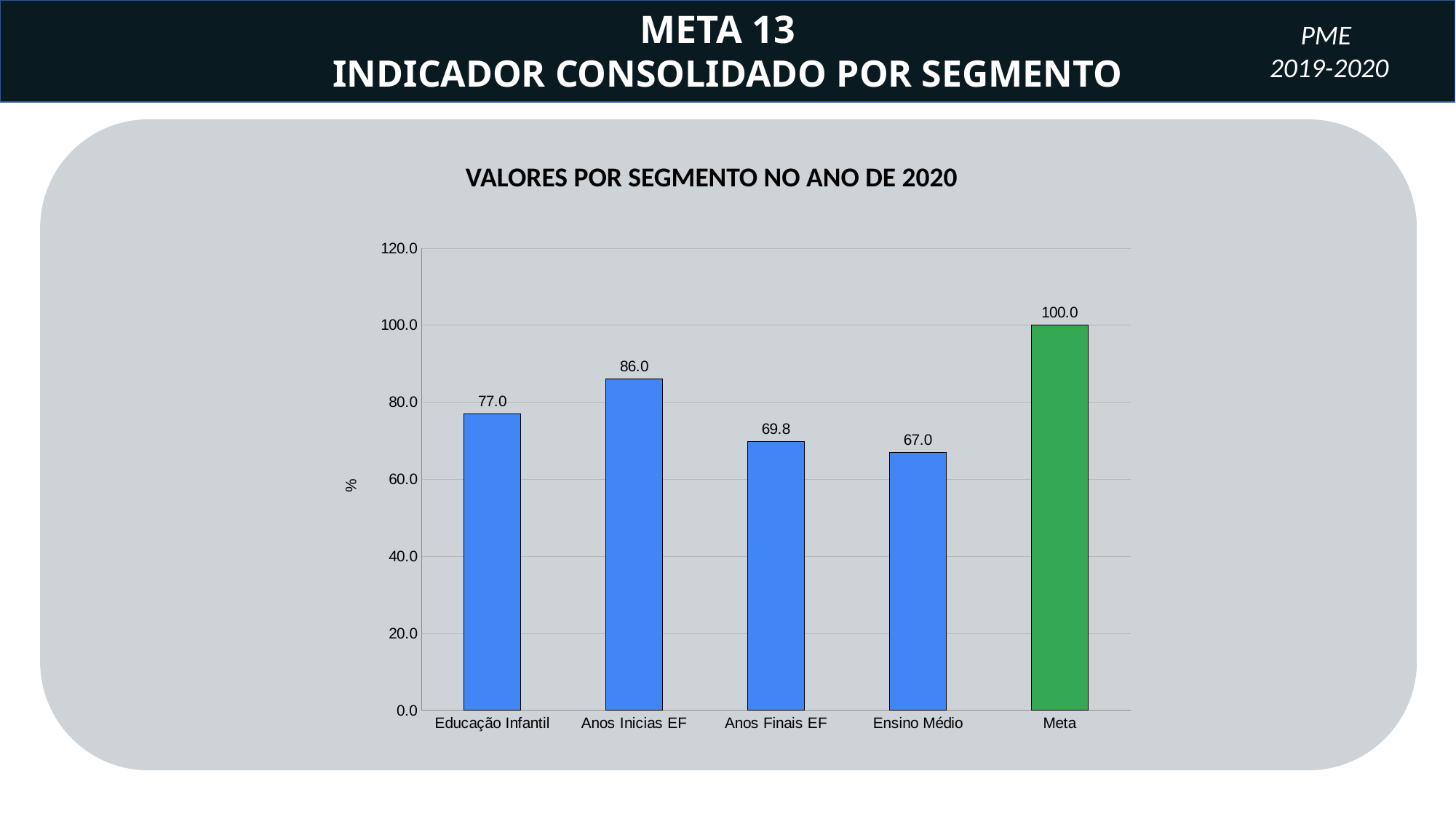
What is the value for Anos Inicias EF? 86.0 What is the difference between the Meta value and the Anos Inicias EF value? 14.0 Which is larger, the value for Educação Infantil or the value for Anos Finais EF? Educação Infantil How many bars are shown in the chart? 5 What colour is the Meta bar? Green What kind of chart is shown on the slide? Bar chart What is the value for Educação Infantil? 77.0 Which category has the highest value? Meta Which category has the lowest value? Ensino Médio What is the value for Ensino Médio? 67.0 What is the value for Anos Finais EF? 69.8 What is the title of the chart? VALORES POR SEGMENTO NO ANO DE 2020